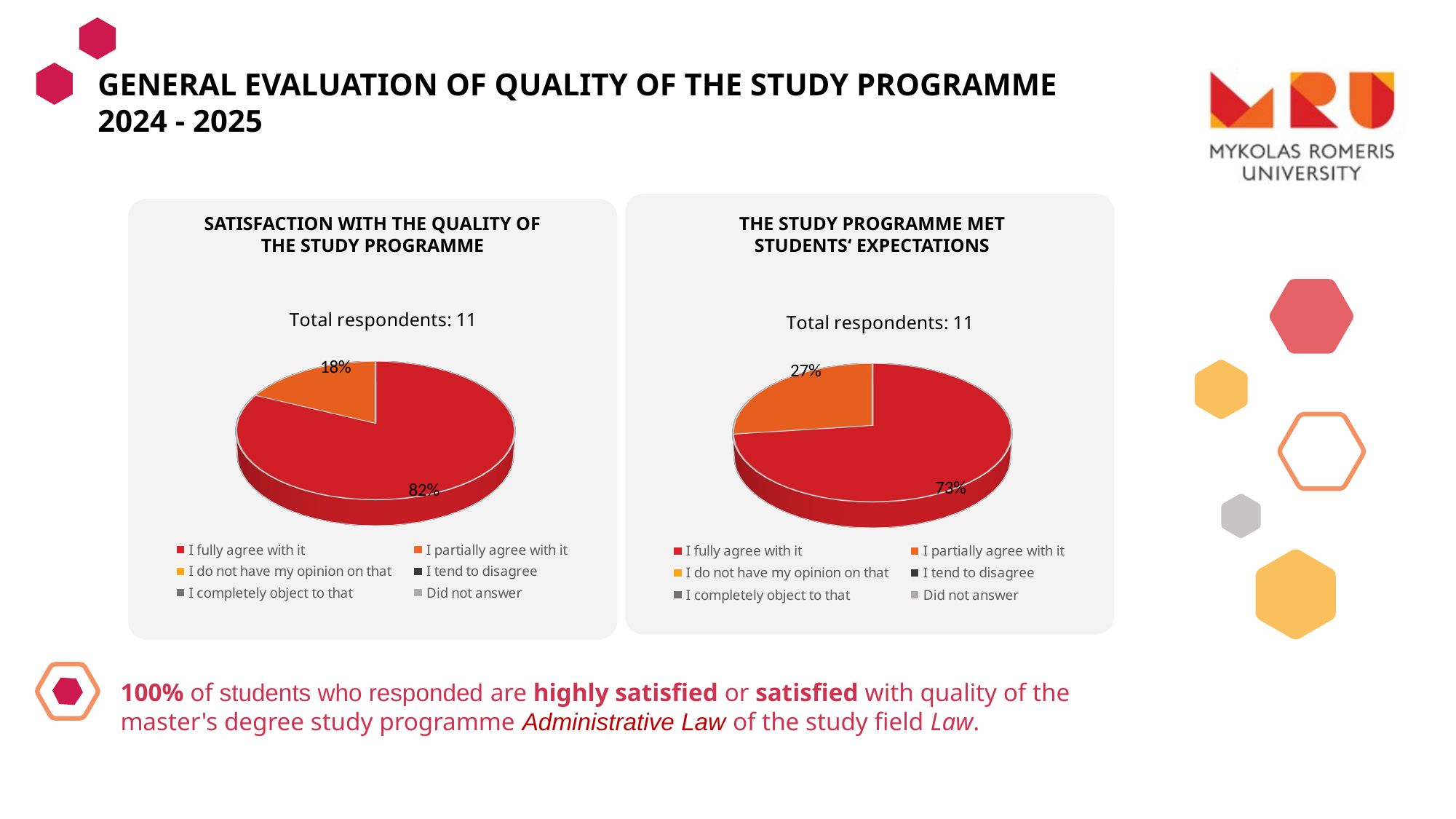
In the 'The study programme met students' expectations' chart, what share of respondents chose 'I fully agree with it'? 73% In the 'Satisfaction with the quality of the study programme' chart, what share of respondents chose 'I partially agree with it'? 18% In the 'Satisfaction with the quality of the study programme' chart, what share of respondents chose 'I fully agree with it'? 82% How many entries does the legend of the 'The study programme met students' expectations' chart list? 6 What type of chart is used in the 'Satisfaction with the quality of the study programme' panel? Pie chart In the 'Satisfaction with the quality of the study programme' chart, which response has the largest share? I fully agree with it In the 'The study programme met students' expectations' chart, what share of respondents chose 'I partially agree with it'? 27% In the 'The study programme met students' expectations' chart, which response has the largest share? I fully agree with it How many total respondents are reported for the 'Satisfaction with the quality of the study programme' chart? 11 In the 'The study programme met students' expectations' chart, what is the difference in percentage points between 'I fully agree with it' and 'I partially agree with it'? 46 In the 'Satisfaction with the quality of the study programme' chart, what is the difference in percentage points between 'I fully agree with it' and 'I partially agree with it'? 64 Which chart has the larger share for 'I partially agree with it': the left chart or the right chart? The right chart